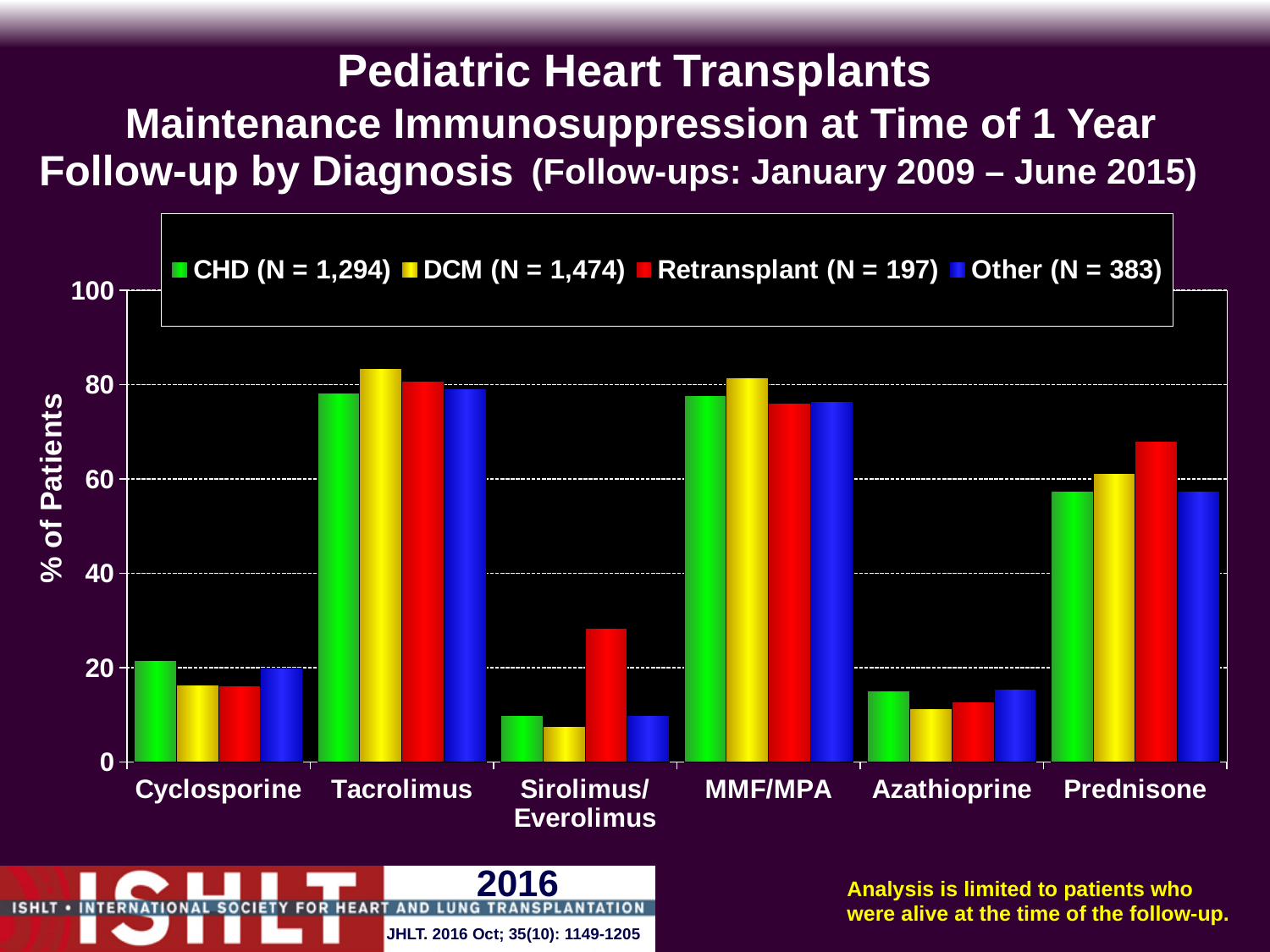
How many series does the legend list? 4 Is the value for DCM in the Tacrolimus category greater or less than 80? greater Is the value for DCM in the Azathioprine category greater or less than 20? less Which diagnosis group has the highest value in the Prednisone category? Retransplant How many drug categories are shown along the x axis? 6 Which diagnosis group has the lowest value in the Sirolimus/Everolimus category? DCM Which diagnosis group has the highest value in the Sirolimus/Everolimus category? Retransplant Is the value for CHD in the Prednisone category greater or less than 60? less What kind of chart is shown on the slide? bar chart In the Cyclosporine category, which is larger: the value for CHD or the value for DCM? CHD According to the legend, what is N for the Retransplant group? 197